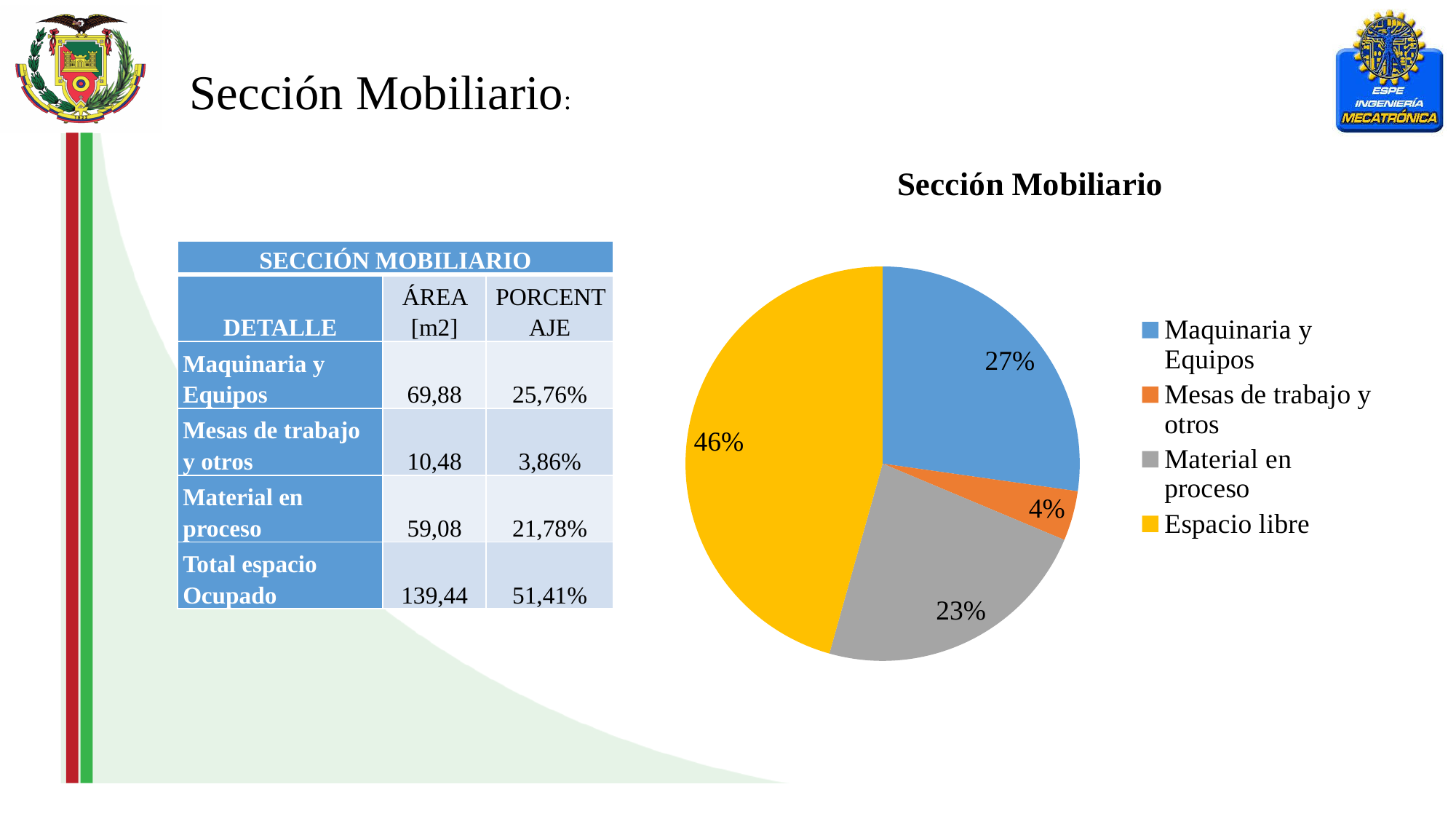
How many categories does the legend list? 4 What percentage does the Material en proceso slice show? 23% Which category has the smallest slice of the pie? Mesas de trabajo y otros What percentage does the Espacio libre slice show? 46% What is the difference in percentage points between the Espacio libre slice and the Material en proceso slice? 23 What is the title of the chart? Sección Mobiliario What colour is the Espacio libre slice? yellow Which slice is larger, Maquinaria y Equipos or Material en proceso? Maquinaria y Equipos What kind of chart is shown on the slide? pie chart What percentage does the Maquinaria y Equipos slice show? 27% Which category has the largest slice of the pie? Espacio libre What percentage does the Mesas de trabajo y otros slice show? 4%